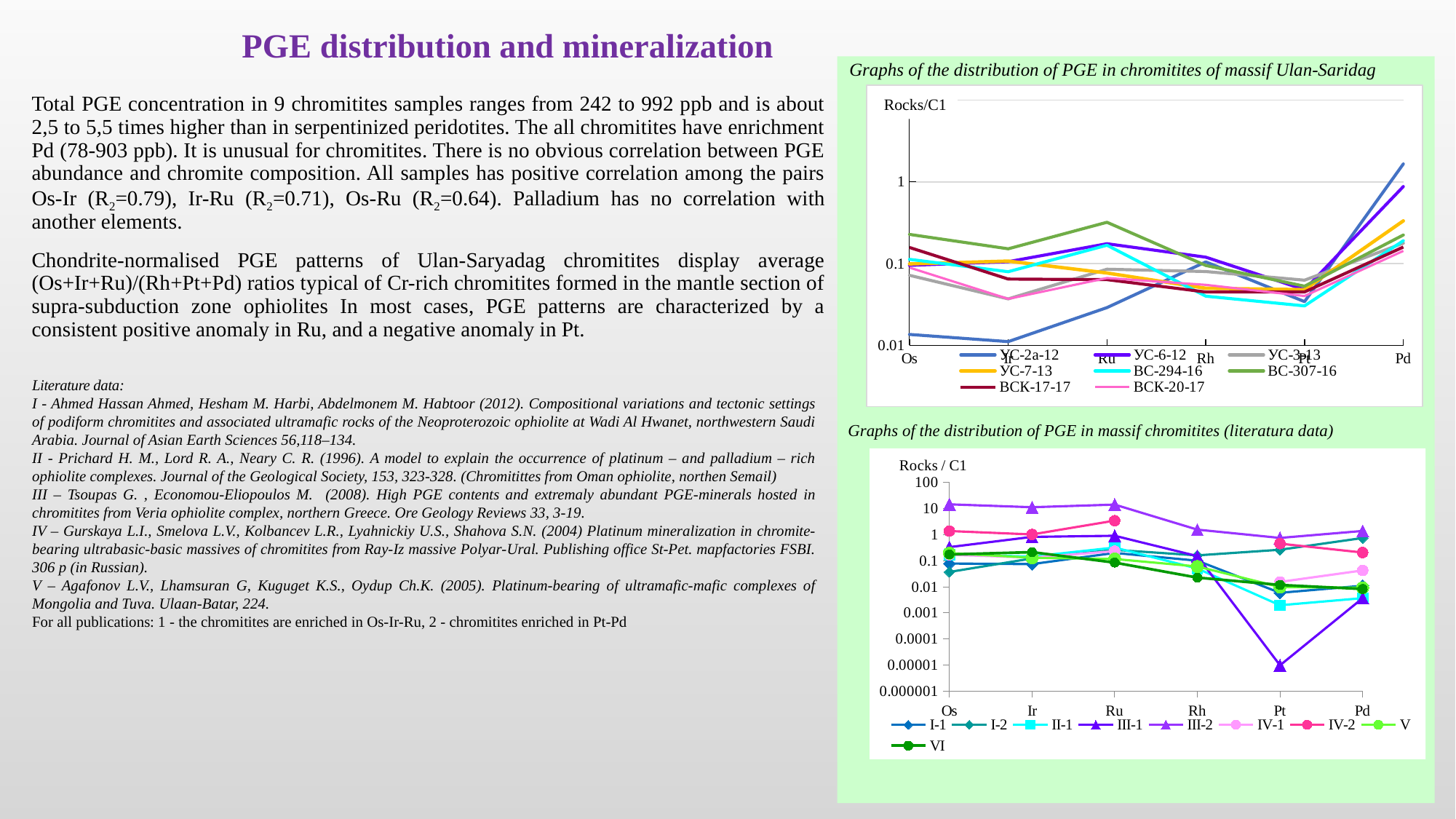
In the top chart (massif Ulan-Saridag), which series has the highest value at Pd? УС-2а-12 What kind of chart is the top chart, 'Graphs of the distribution of PGE in chromitites of massif Ulan-Saridag'? Line chart How many series does the legend of the top chart (massif Ulan-Saridag) list? 8 How many series does the legend of the bottom chart (literatura data) list? 9 In the bottom chart (literatura data), is the value of III-2 at Os greater or less than 10? greater In the top chart (massif Ulan-Saridag), is the value of ВС-307-16 at Ru greater or less than 0.1? greater In the bottom chart (literatura data), which is larger at Os: III-2 or VI? III-2 What is the y-axis label of the top chart (massif Ulan-Saridag)? Rocks/C1 How many elements are plotted along the x axis of the top chart (massif Ulan-Saridag)? 6 In the bottom chart (literatura data), which series has the lowest value at Pt? III-1 In the top chart (massif Ulan-Saridag), does the УС-2а-12 line rise or fall from Pt to Pd? Rise In the top chart (massif Ulan-Saridag), is the value of УС-2а-12 at Pd greater or less than 1? greater